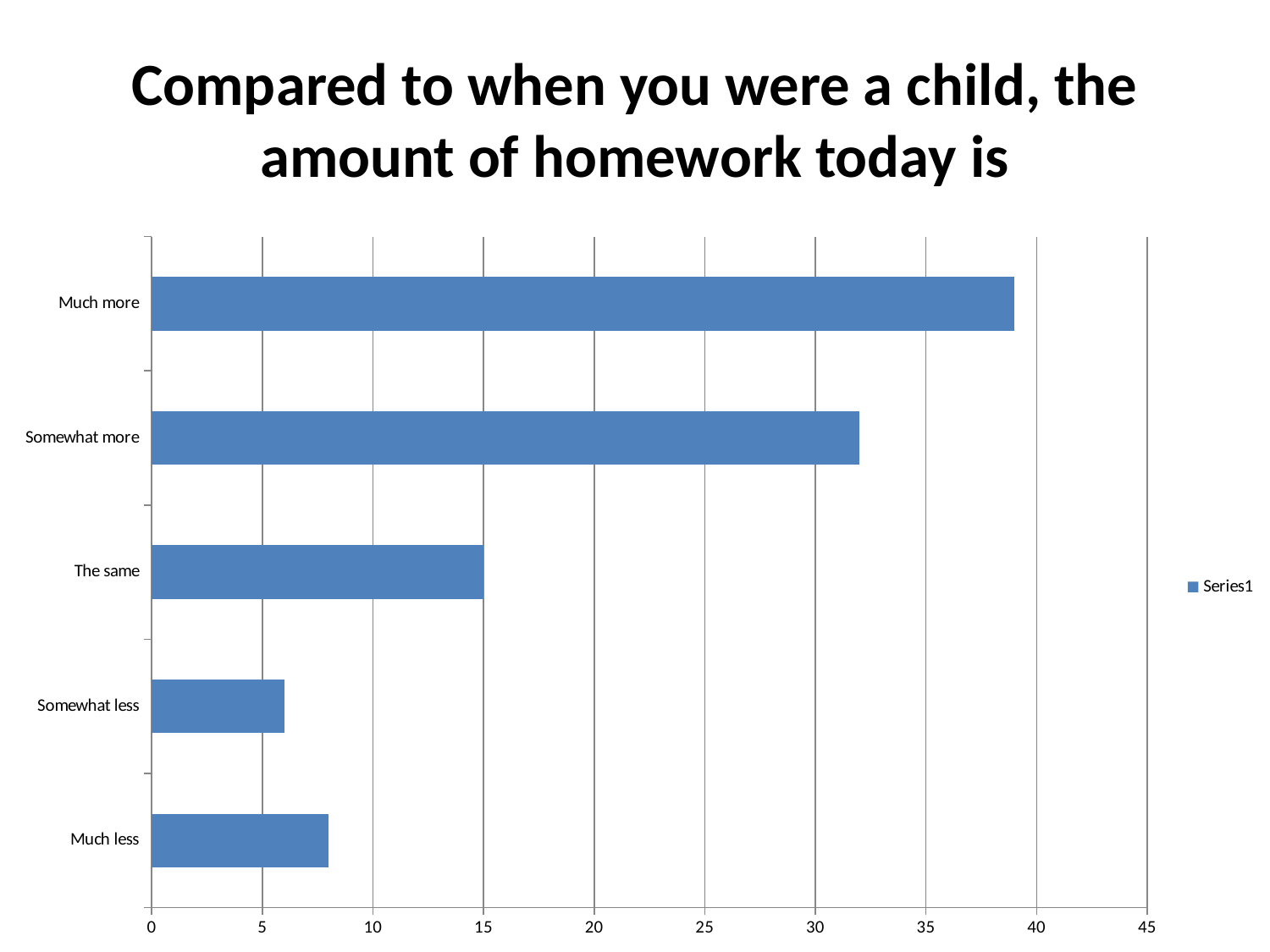
Is the value for Much more greater or less than 40? less Which is larger, the value for Somewhat more or the value for The same? Somewhat more What kind of chart is shown on the slide? bar chart Is the value for Somewhat more greater or less than 30? greater What is the name of the series shown in the legend? Series1 Is the value for Much less greater or less than 10? less How many series does the legend list? 1 How many categories are plotted in the chart? 5 Which is larger, the value for Much less or the value for Somewhat less? Much less Which category has the lowest value? Somewhat less Which category has the highest value? Much more